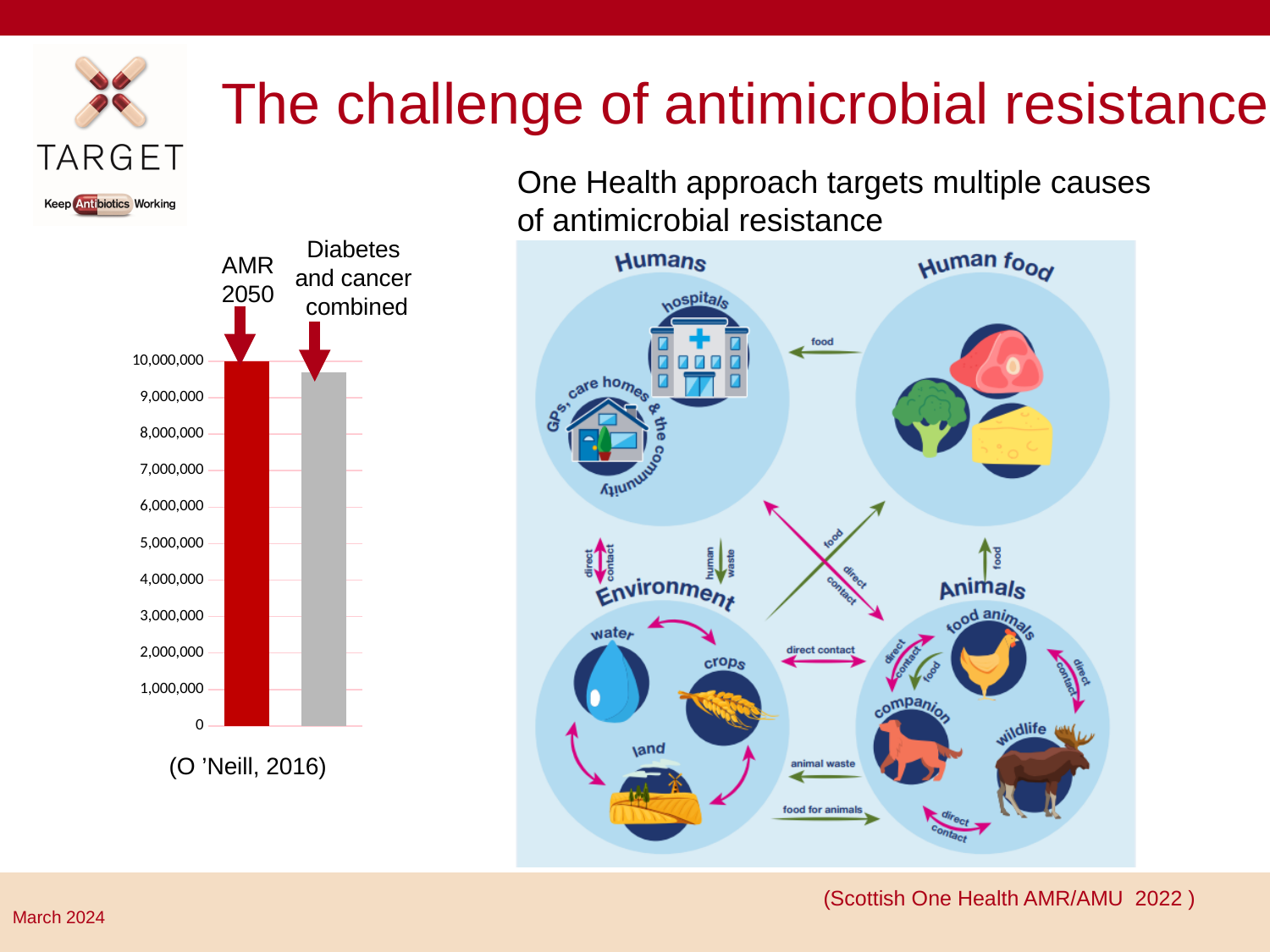
Which bar is taller on the chart: AMR 2050 or Diabetes and cancer combined? AMR 2050 Is the value for Diabetes and cancer combined greater or less than 9,000,000? greater What colour is the AMR 2050 bar on the chart? red What kind of chart is shown on the left of the slide? bar chart What is the highest value shown on the vertical axis of the chart? 10,000,000 How many bars does the chart on the left of the slide show? 2 Which category has the highest value on the chart? AMR 2050 Which category has the lowest value on the chart? Diabetes and cancer combined Is the value for AMR 2050 greater or less than 5,000,000? greater Is the value for Diabetes and cancer combined greater or less than 10,000,000? less What value does the AMR 2050 bar reach on the chart? 10,000,000